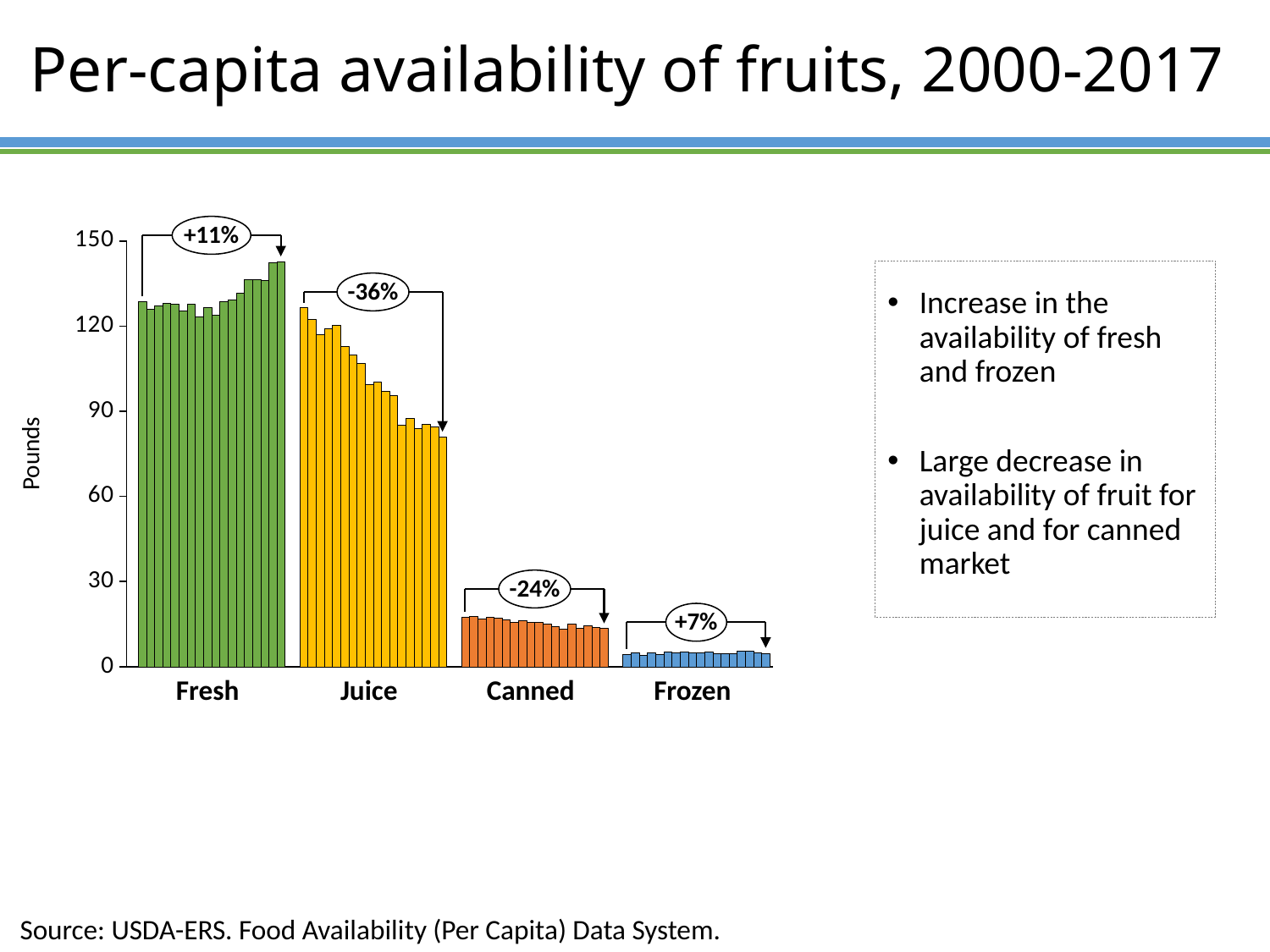
Is the per-capita availability of Fresh fruit in 2017 greater or less than 120 pounds? greater Do the Juice bars rise or fall from 2000 to 2017? fall What percentage change is annotated for the Frozen category? +7% What kind of chart is shown on the slide? bar chart What percentage change is annotated for the Fresh category? +11% What percentage change is annotated for the Canned category? -24% Is the per-capita availability of Juice in 2017 greater or less than 90 pounds? less How many fruit categories are shown on the x axis? 4 Which fruit category has the lowest per-capita availability in pounds? Frozen What percentage change is annotated for the Juice category? -36% Which category shows the largest percentage decrease over 2000-2017? Juice Which fruit category has the highest per-capita availability in pounds? Fresh